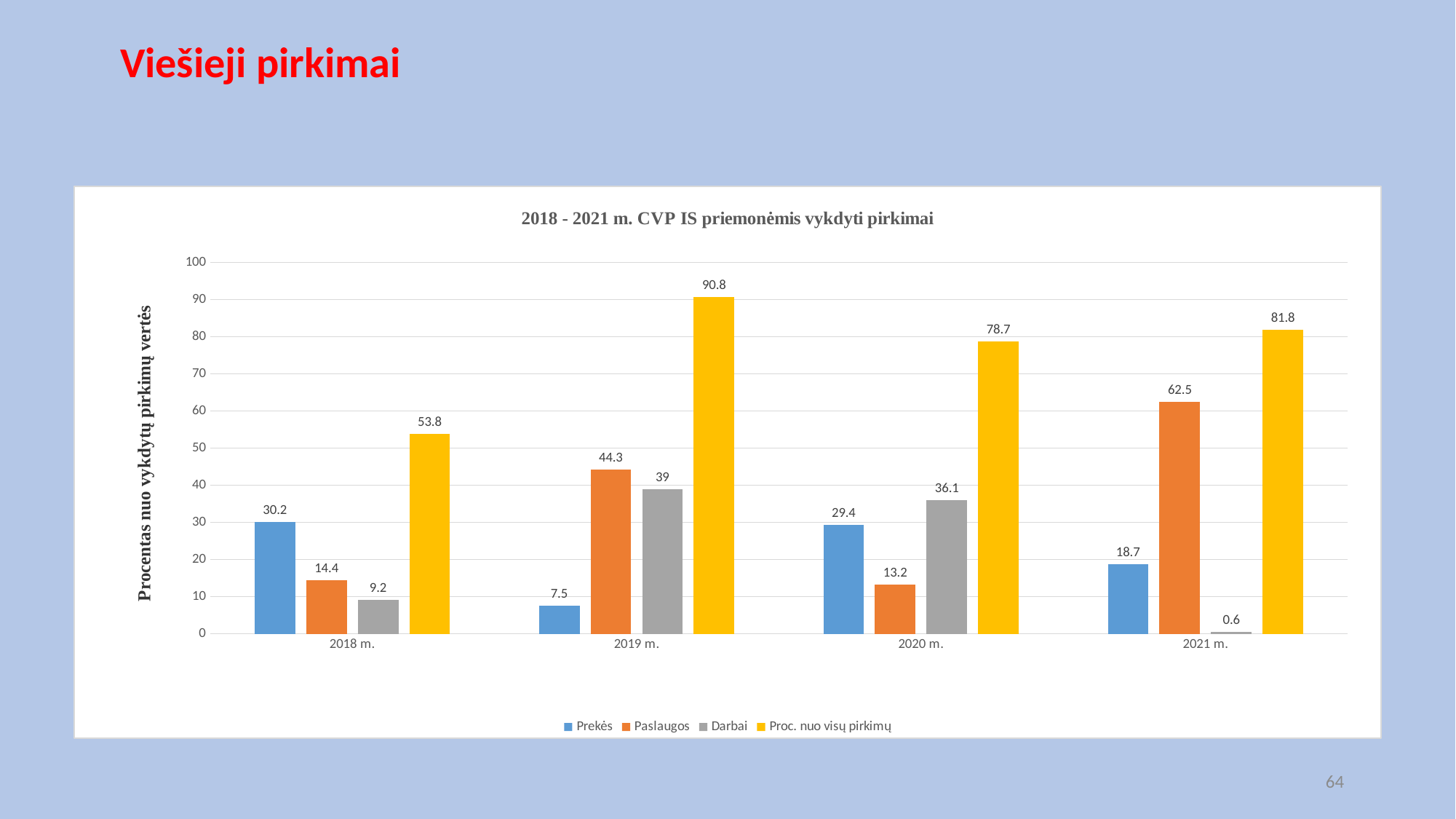
What kind of chart is shown? bar chart How many series does the legend list? 4 What is the title of the chart? 2018 - 2021 m. CVP IS priemonėmis vykdyti pirkimai Is the value for Paslaugos in 2021 m. greater or less than 60? greater In which year is the Prekės value lowest? 2019 m. What is the value for Paslaugos in 2019 m.? 44.3 How many years are shown on the x axis? 4 Which is larger: Darbai in 2019 m. or Darbai in 2020 m.? Darbai in 2019 m. In which year is the Proc. nuo visų pirkimų value highest? 2019 m. What is the difference between the Proc. nuo visų pirkimų values for 2019 m. and 2018 m.? 37 What is the value for Darbai in 2021 m.? 0.6 What is the value for Prekės in 2020 m.? 29.4